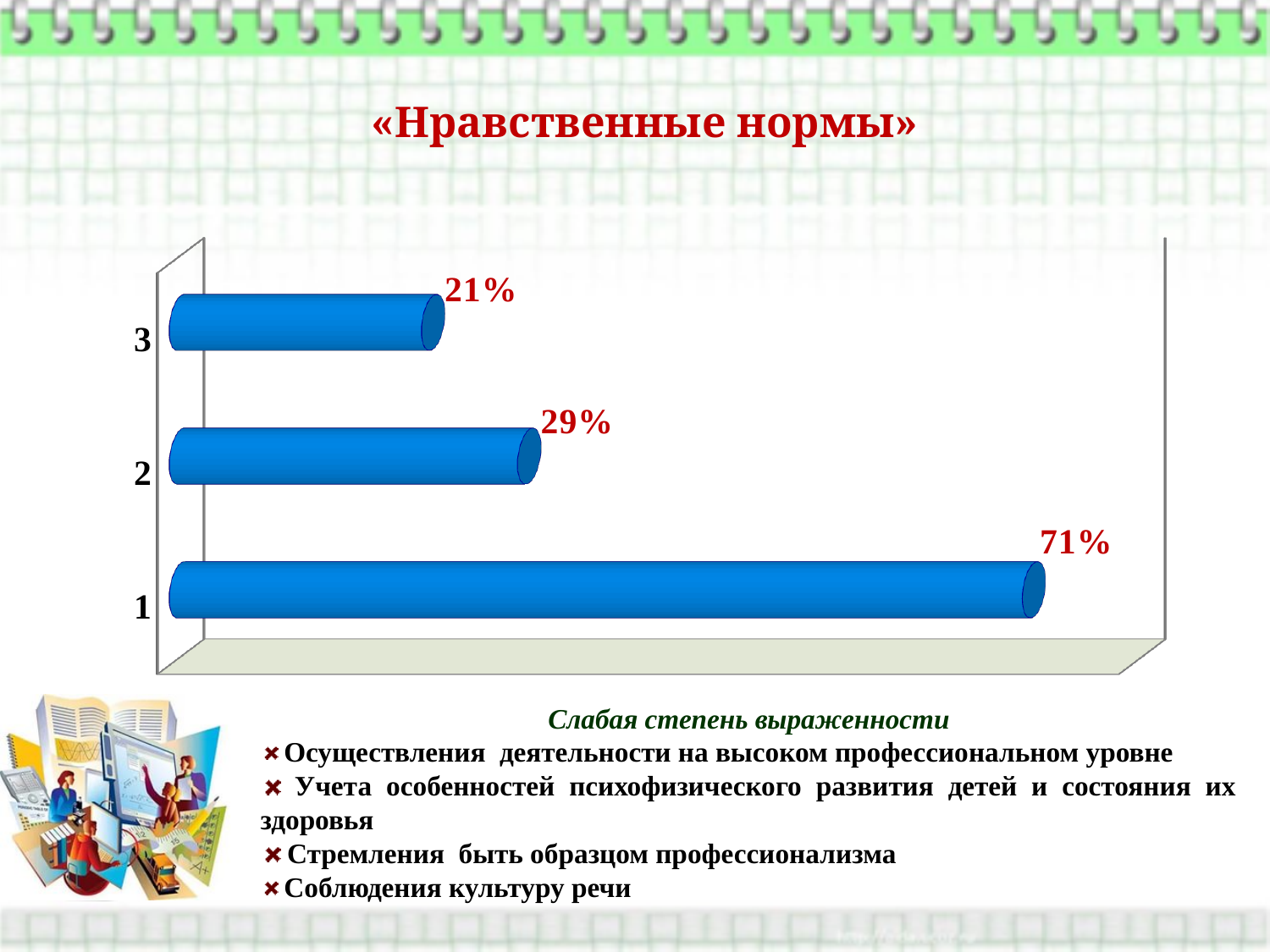
What is the value for category 2? 29% What is the difference between the values for category 2 and category 3? 8% What colour are the bars in the chart? blue How many bars are shown in the chart? 3 What is the title of the chart? «Нравственные нормы» What is the value for category 1? 71% Which category has the highest value? 1 What is the difference between the values for category 1 and category 2? 42% What kind of chart is shown on the slide? bar chart Which is larger, the value for category 2 or category 3? category 2 What is the value for category 3? 21% Which category has the lowest value? 3